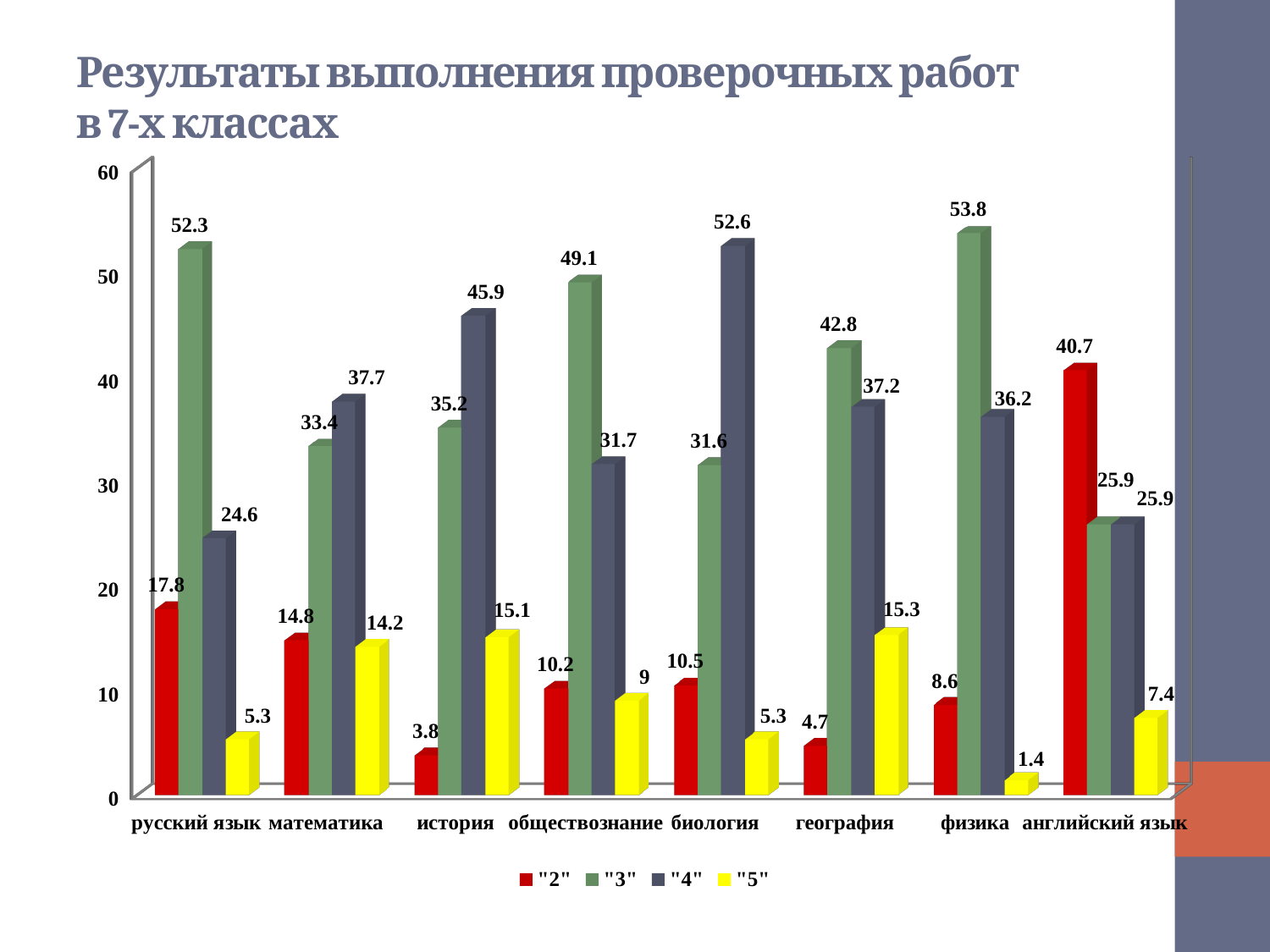
What is the value of series "3" for физика? 53.8 What is the value of series "5" for география? 15.3 What kind of chart is shown on the slide? bar chart Which subject has the highest value for series "4"? биология What is the difference between series "4" and series "2" for история? 42.1 Which subject has the highest value for series "2"? английский язык What is the difference between series "4" and series "3" for математика? 4.3 How many subjects are shown on the x axis? 8 How many series does the legend list? 4 What is the value of series "2" for английский язык? 40.7 Which is larger: series "3" for русский язык or series "3" for обществознание? русский язык Which subject has the lowest value for series "5"? физика